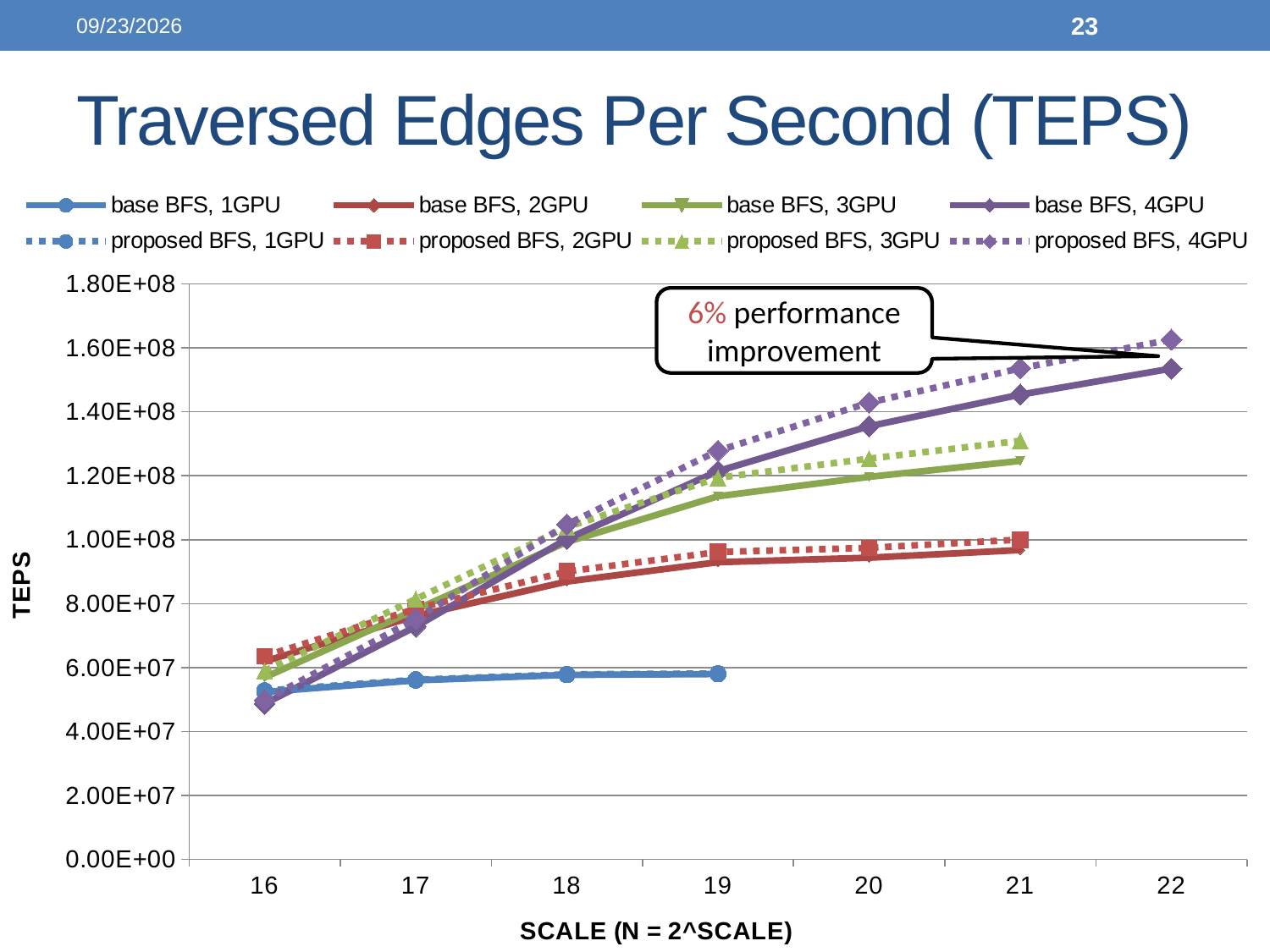
Is the value for base BFS, 4GPU at SCALE 22 greater or less than 1.60E+08? less Does the TEPS value for base BFS, 4GPU rise or fall as SCALE increases from 16 to 22? rise How many series does the legend list? 8 What is the title of the chart? Traversed Edges Per Second (TEPS) Is the value for proposed BFS, 3GPU at SCALE 21 greater or less than 1.20E+08? greater Which series reaches the highest TEPS value on the chart? proposed BFS, 4GPU At SCALE 22, which is larger: proposed BFS, 4GPU or base BFS, 4GPU? proposed BFS, 4GPU At SCALE 20, which is larger: base BFS, 4GPU or base BFS, 3GPU? base BFS, 4GPU Is the value for base BFS, 1GPU at SCALE 16 greater or less than 6.00E+07? less What kind of chart is shown on the slide? line chart How many SCALE values are shown on the x axis? 7 What performance improvement does the callout on the chart state? 6% performance improvement